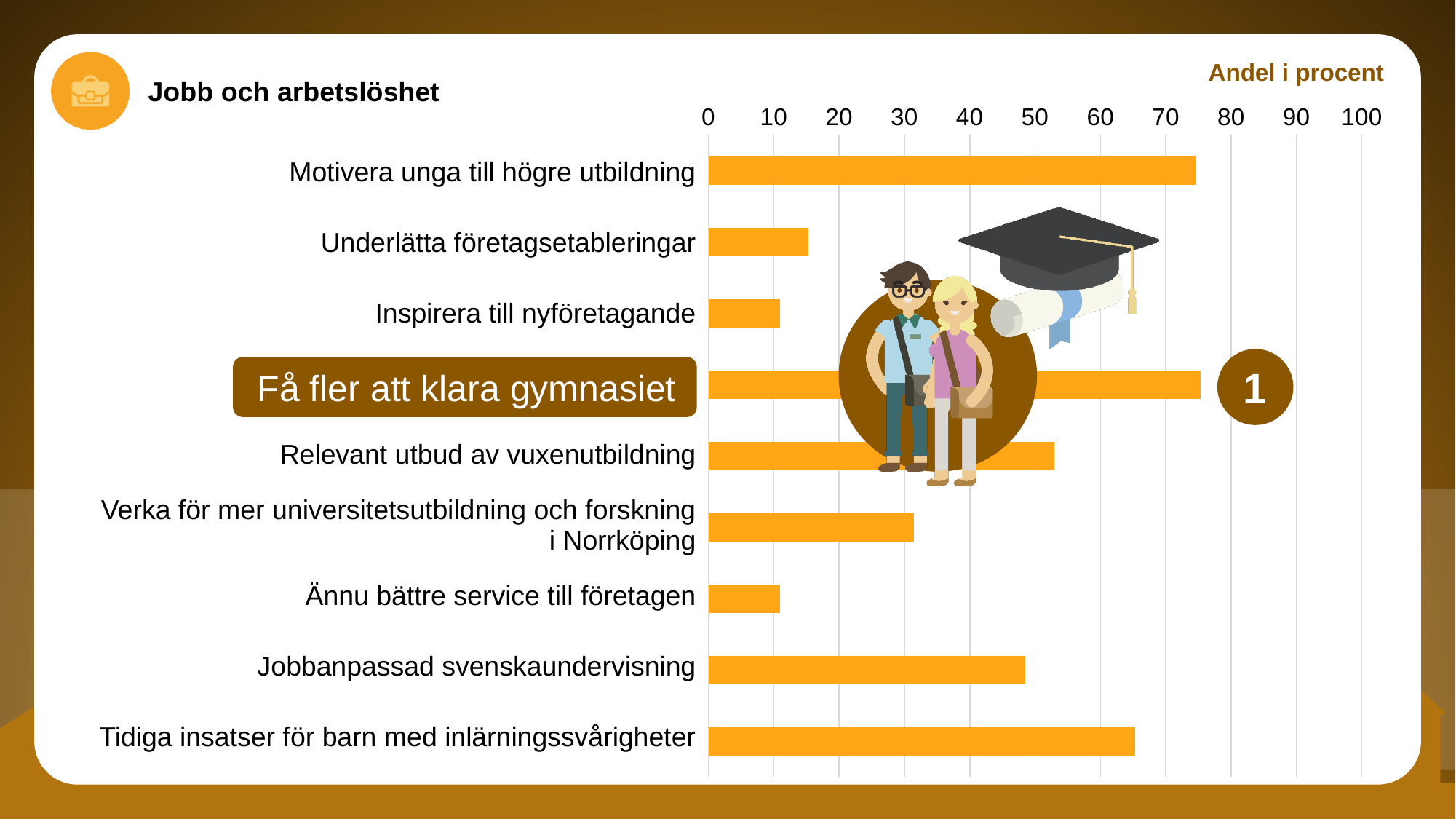
Is the value for "Jobbanpassad svenskaundervisning" greater or less than 40? greater Is the value for "Motivera unga till högre utbildning" greater or less than 70? greater Which has a larger value: "Motivera unga till högre utbildning" or "Underlätta företagsetableringar"? Motivera unga till högre utbildning What unit label is shown above the chart's horizontal axis? Andel i procent Which has a larger value: "Tidiga insatser för barn med inlärningssvårigheter" or "Relevant utbud av vuxenutbildning"? Tidiga insatser för barn med inlärningssvårigheter What kind of chart is shown on the slide? bar chart How many categories (bars) does the chart show? 9 Is the value for "Underlätta företagsetableringar" greater or less than 20? less Which category label is highlighted with a brown box and marked with the number 1? Få fler att klara gymnasiet